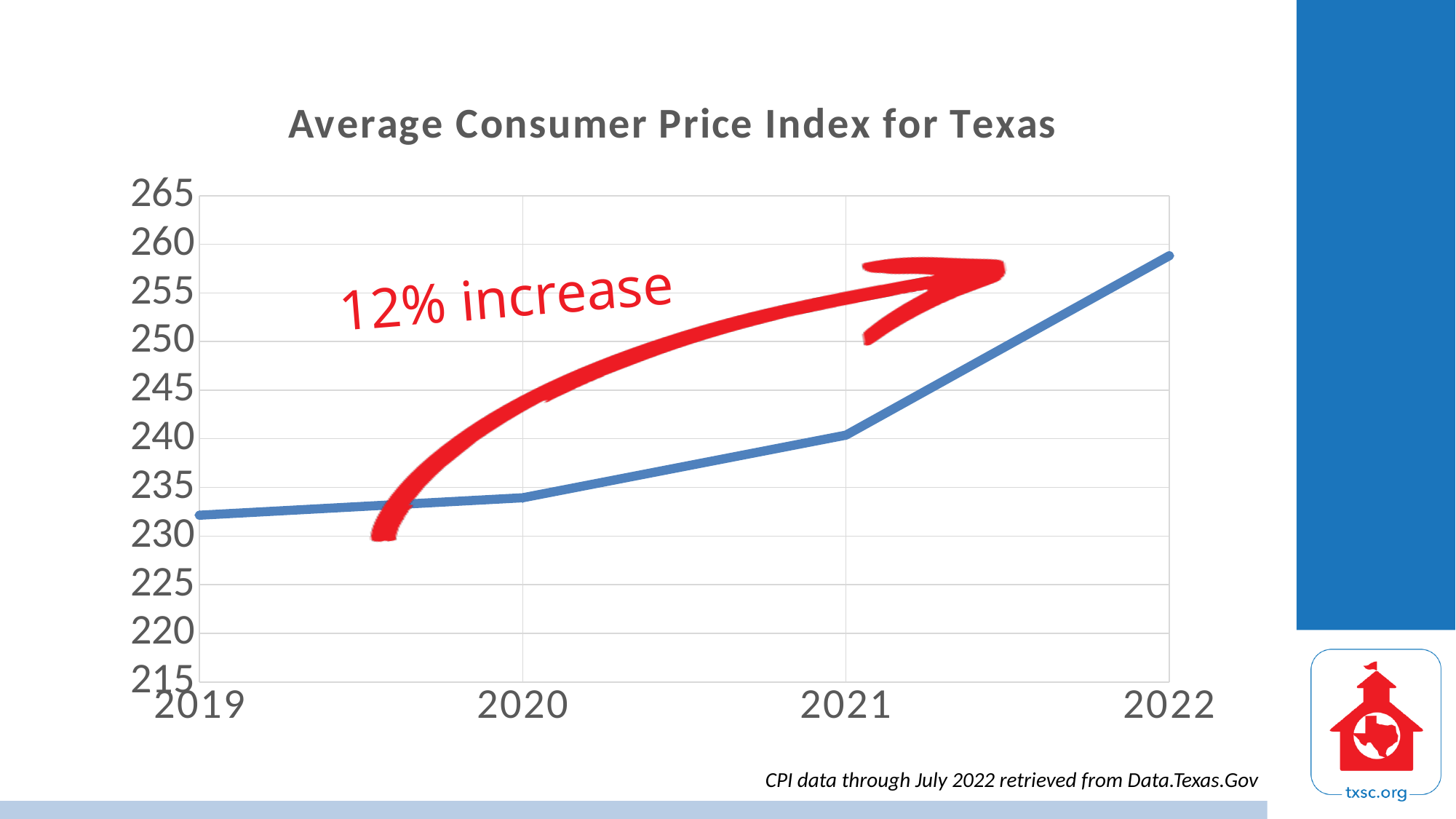
Is the value for 2022 greater or less than 255? greater What kind of chart is shown on the slide? line chart Is the value for 2019 greater or less than 235? less Is the value for 2020 greater or less than 230? greater Which year has a larger value, 2020 or 2021? 2021 How many years are plotted on the x axis of the chart? 4 Which year has the lowest Average Consumer Price Index for Texas? 2019 What is the title of the chart? Average Consumer Price Index for Texas Which year has the highest Average Consumer Price Index for Texas? 2022 What percentage increase does the red annotation on the chart state? 12% increase Do the values rise or fall from 2019 to 2022? rise